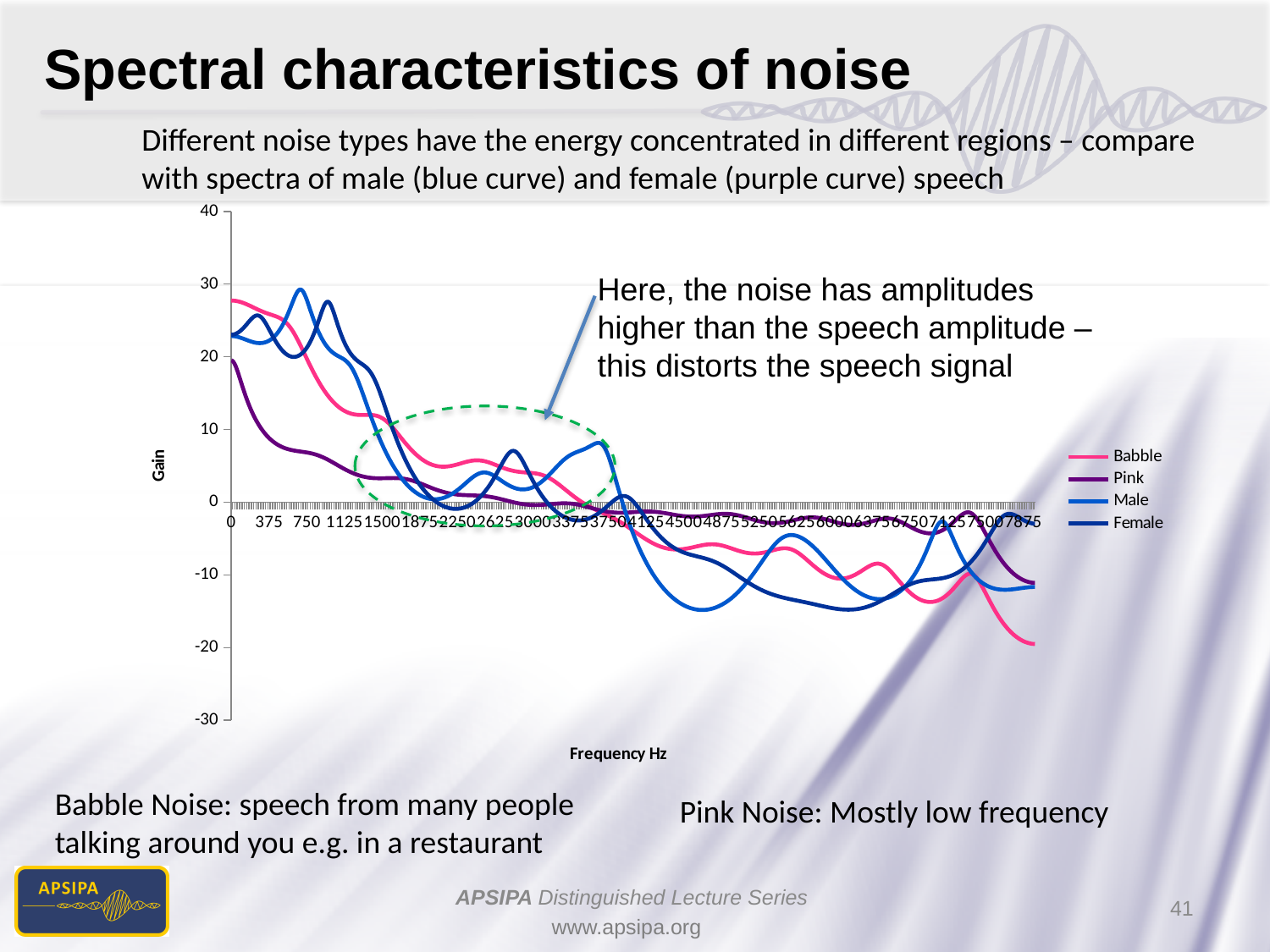
What kind of chart is shown on the slide? line chart What are the series names listed in the chart legend? Babble, Pink, Male, Female Is the Pink value at 750 Hz greater or less than 10? less Is the Female value at 0 Hz greater or less than 20? greater Is the Babble value at 0 Hz greater or less than 20? greater How many series does the chart legend list? 4 Does the Babble curve generally rise or fall as frequency increases from 0 to 7875 Hz? fall At 7875 Hz, which is larger, the Babble value or the Pink value? Pink What is the title of the vertical axis of the chart? Gain Which series has the lowest value at 0 Hz? Pink Which series has the highest value at 0 Hz? Babble